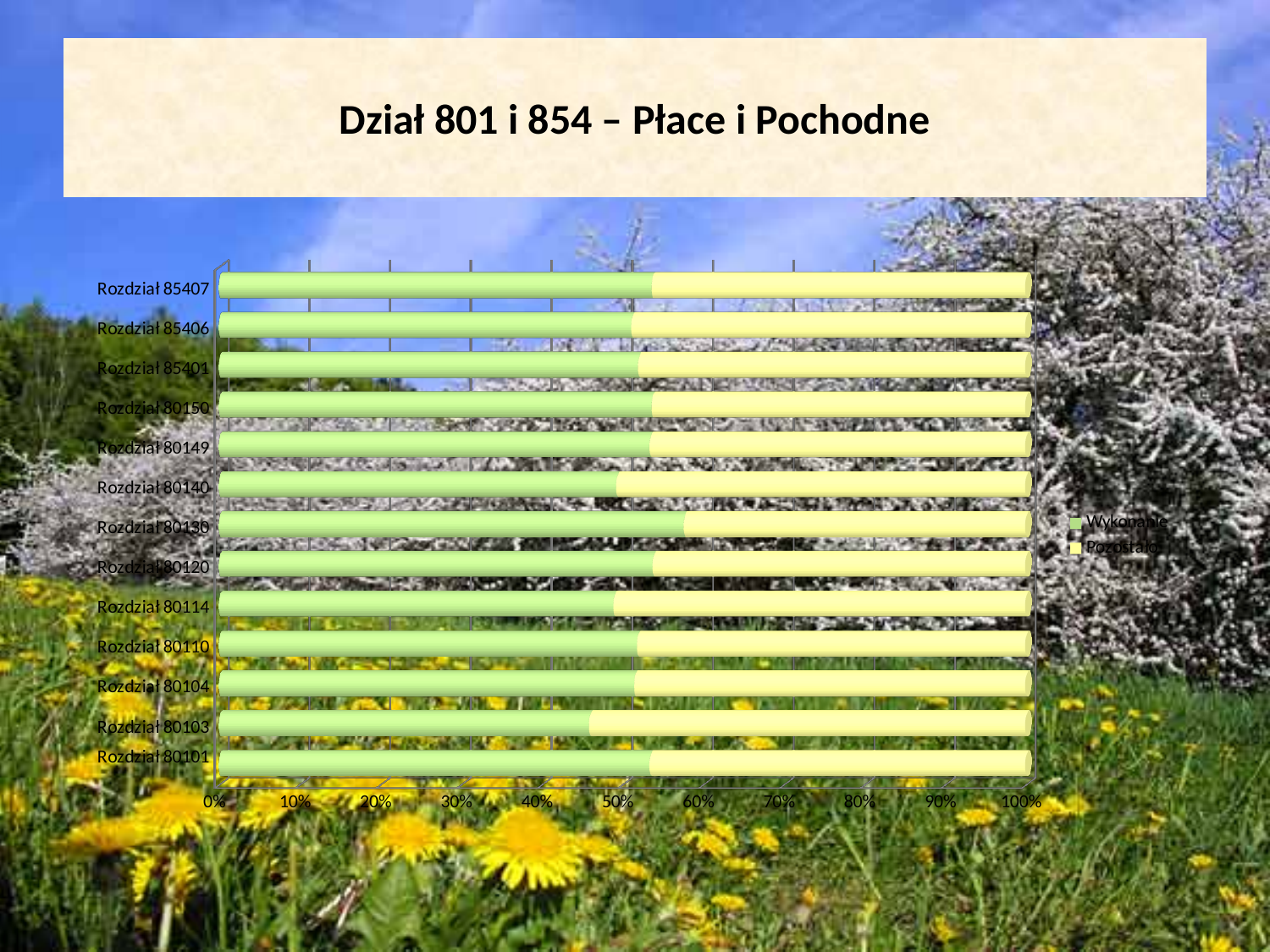
Which category has the lowest Wykonanie share? Rozdział 80103 Is the Wykonanie value for Rozdział 80130 greater or less than 50%? greater How many categories (Rozdział entries) are plotted on the chart? 13 What is the total of the stacked bar for Rozdział 85407? 100% Is the Wykonanie value for Rozdział 80103 greater or less than 50%? less Which has the larger Wykonanie share, Rozdział 80130 or Rozdział 80140? Rozdział 80130 What kind of chart is shown on the slide? Stacked bar chart Which category has the highest Wykonanie share? Rozdział 80130 How many series does the legend list? 2 Is the Pozostało value for Rozdział 80103 greater or less than 50%? greater What is the title of the slide containing the chart? Dział 801 i 854 – Płace i Pochodne Which series is shown in green in the legend? Wykonanie